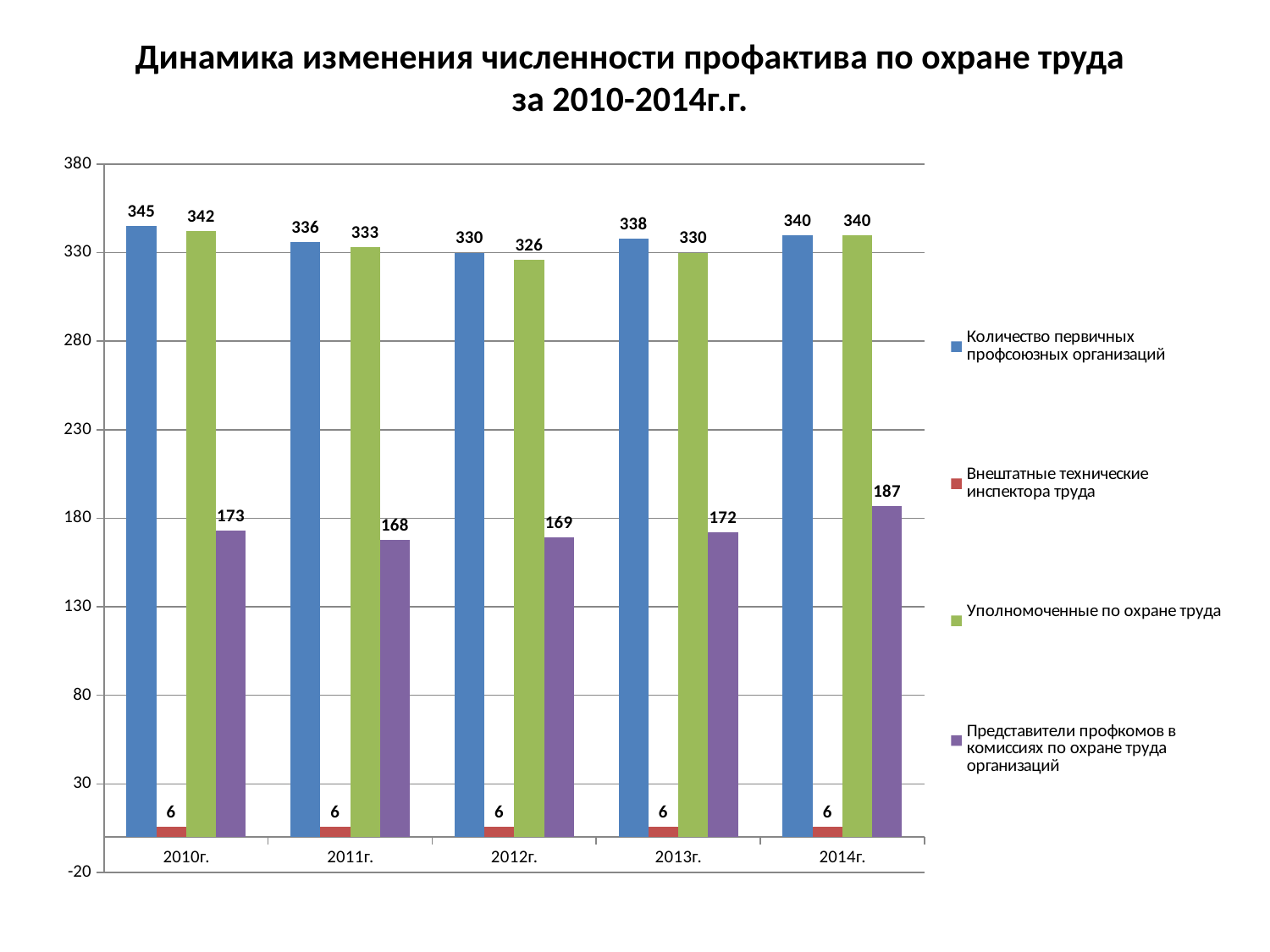
In which year is the value for "Уполномоченные по охране труда" lowest? 2012г. What is the difference between the values for "Количество первичных профсоюзных организаций" in 2010г. and 2012г.? 15 How many years are shown on the x axis? 5 What is the value for "Представители профкомов в комиссиях по охране труда организаций" in 2014г.? 187 Which is larger: "Уполномоченные по охране труда" in 2011г. or in 2013г.? 2011г. Which colour represents "Внештатные технические инспектора труда" in the legend? Red What is the value for "Уполномоченные по охране труда" in 2012г.? 326 What kind of chart is shown on the slide? Bar chart What is the value for "Количество первичных профсоюзных организаций" in 2010г.? 345 How many series does the legend list? 4 What is the value for "Внештатные технические инспектора труда" in 2013г.? 6 In which year is the value for "Представители профкомов в комиссиях по охране труда организаций" highest? 2014г.